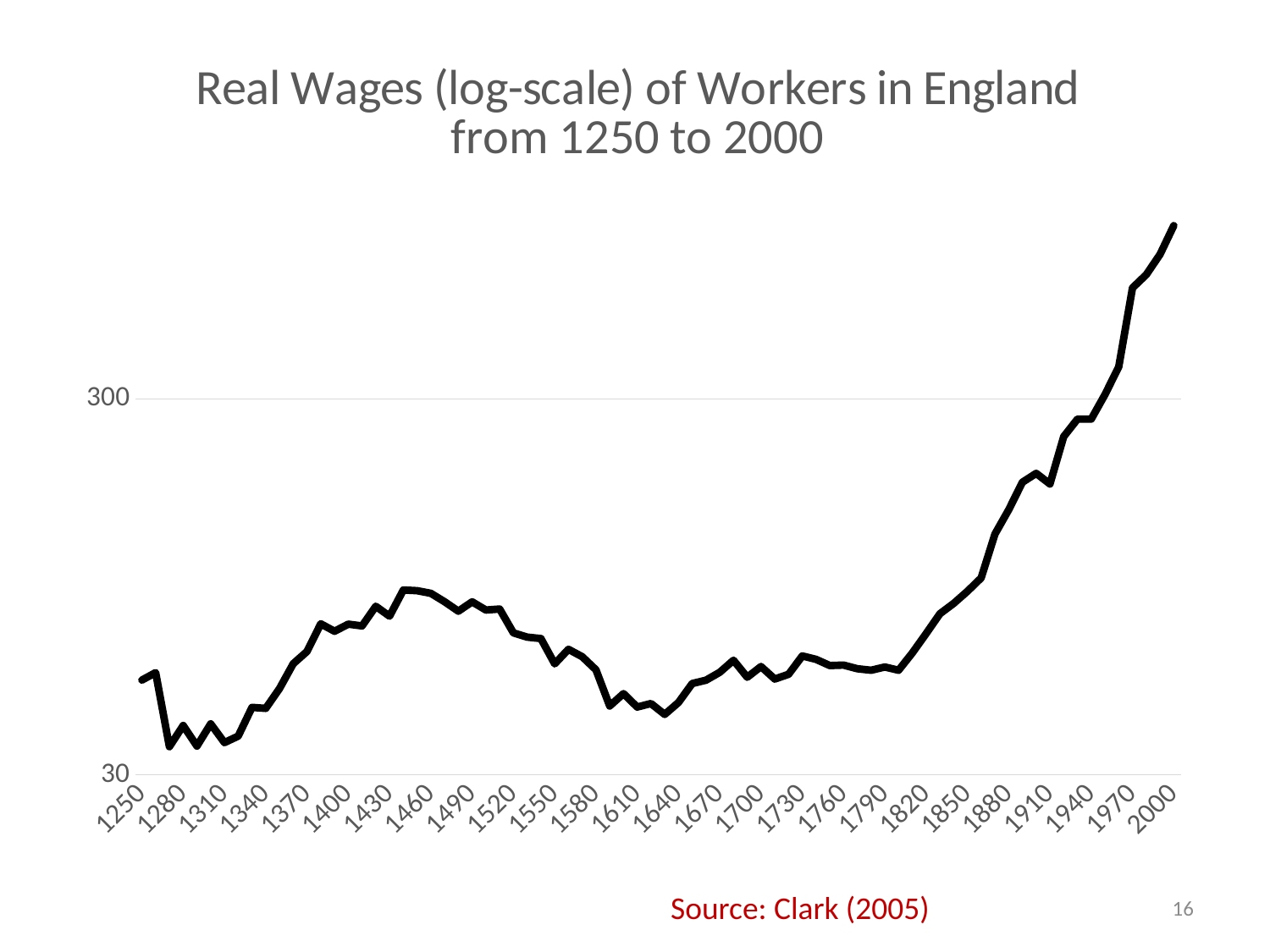
Which is larger, the value for 1460 or the value for 1610? 1460 What source is cited below the chart? Clark (2005) Is the value for 1910 greater or less than 300? less What is the title of the chart? Real Wages (log-scale) of Workers in England from 1250 to 2000 Do the values rise or fall between 1850 and 2000? rise In which year does the line reach its highest value? 2000 Which is larger, the value for 1250 or the value for 2000? 2000 Is the value for 1970 greater or less than 300? greater What kind of chart is shown on the slide? line chart How many year labels are shown on the x axis? 26 Is the value for 2000 greater or less than 300? greater